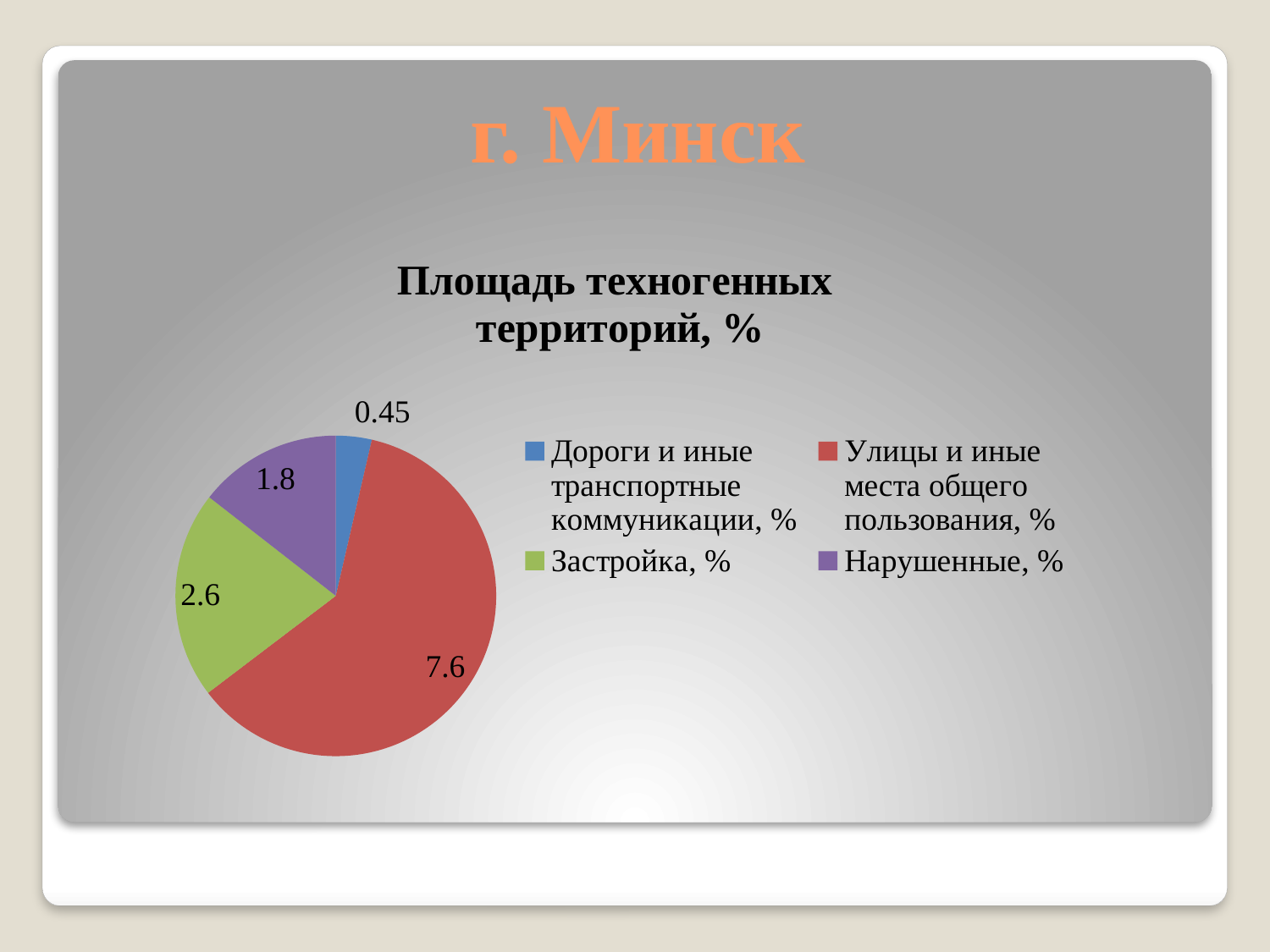
What is the value for Застройка? 2.6 What is the difference between the values for Застройка and Нарушенные? 0.8 What is the value for Улицы и иные места общего пользования? 7.6 What type of chart is shown on the slide? pie chart What is the value for Нарушенные? 1.8 Which category has the smallest slice of the pie? Дороги и иные транспортные коммуникации Which is larger: the value for Нарушенные or the value for Застройка? Застройка Which category has the largest slice of the pie? Улицы и иные места общего пользования What is the value for Дороги и иные транспортные коммуникации? 0.45 What is the title of the chart? Площадь техногенных территорий, % How many categories does the pie chart have? 4 What is the difference between the values for Улицы и иные места общего пользования and Застройка? 5